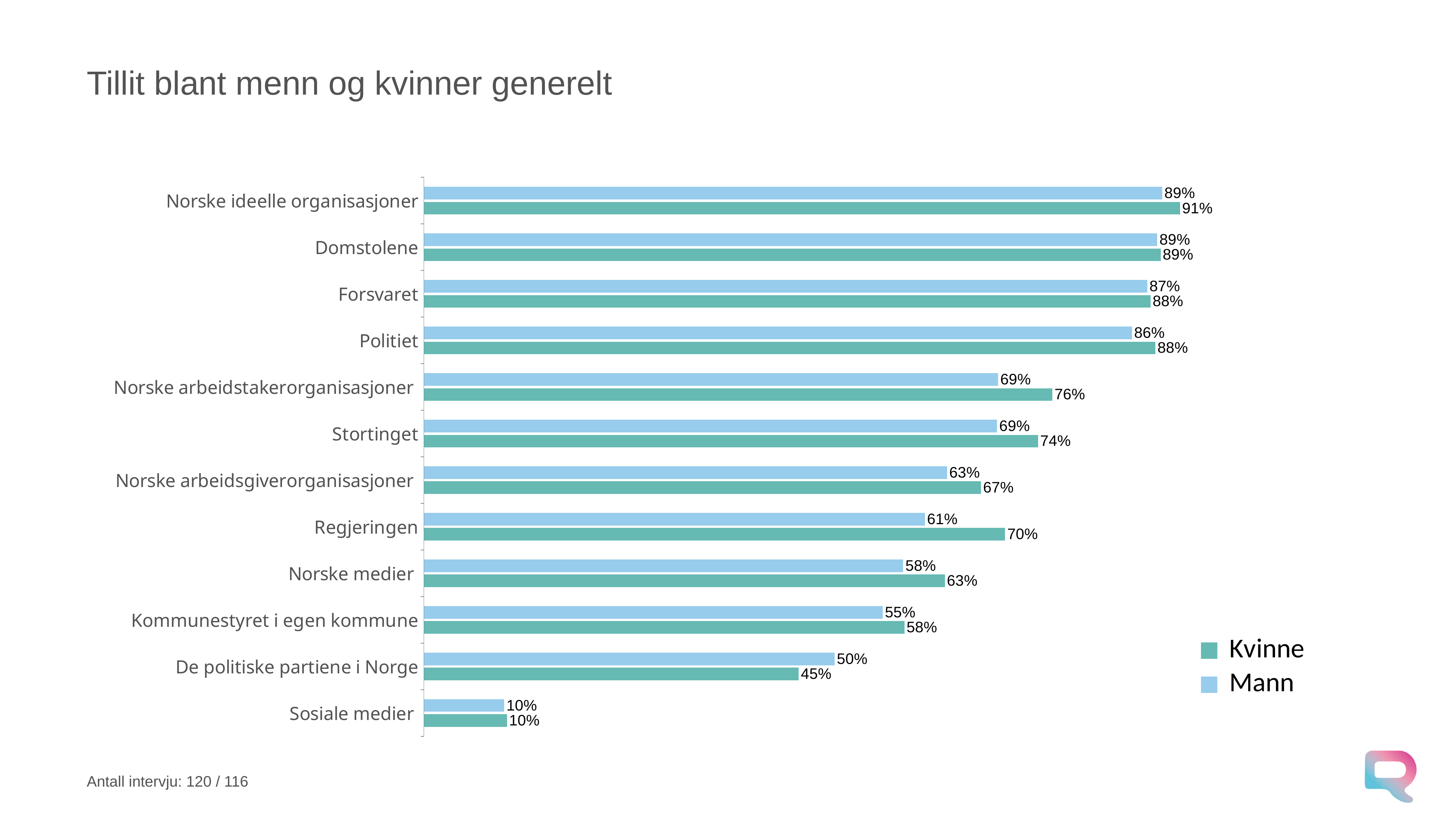
What is the Kvinne value for De politiske partiene i Norge? 45% Which category has the lowest Mann value? Sosiale medier What is the difference between the Kvinne and Mann values for Regjeringen? 9% What is the difference between the Kvinne and Mann values for Norske arbeidstakerorganisasjoner? 7% Which category has the highest Kvinne value? Norske ideelle organisasjoner How many series does the legend list? 2 How many categories are shown on the chart? 12 What is the Mann value for Regjeringen? 61% What is the Kvinne value for Norske ideelle organisasjoner? 91% For De politiske partiene i Norge, which is larger: the Kvinne value or the Mann value? Mann Which is larger: the Kvinne value for Stortinget or the Kvinne value for Norske medier? Stortinget What kind of chart is shown on the slide? Bar chart